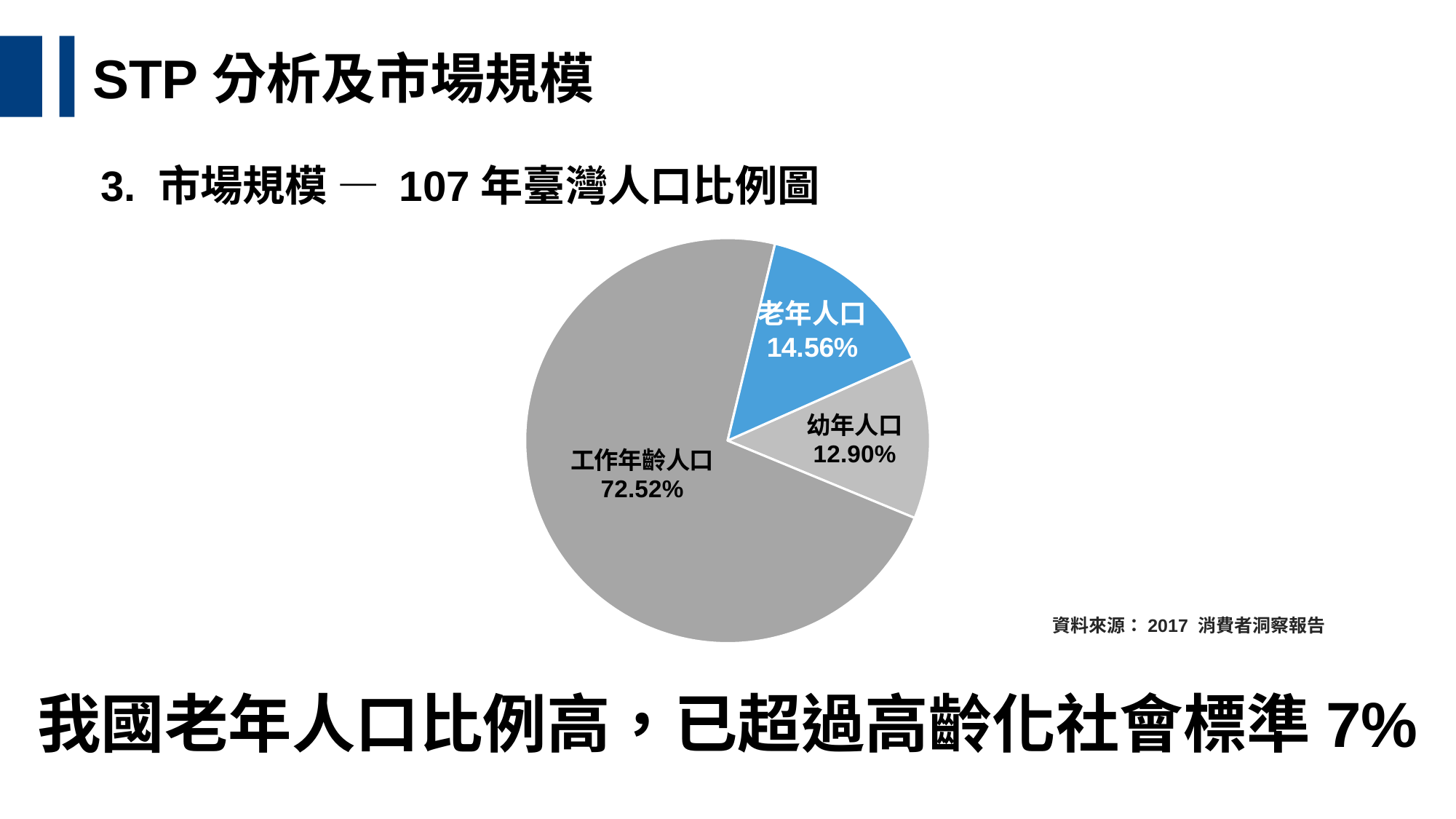
What is the difference between the values for 工作年齡人口 and 老年人口? 57.96% What is the difference between the values for 老年人口 and 幼年人口? 1.66% Which category has the largest slice? 工作年齡人口 Which slice is coloured blue? 老年人口 What is the data source cited below the chart? 2017 消費者洞察報告 Which category has the smallest slice? 幼年人口 What is the value for 工作年齡人口? 72.52% How many slices does the pie chart have? 3 Which is larger, 老年人口 or 幼年人口? 老年人口 What is the value for 老年人口? 14.56% What is the value for 幼年人口? 12.90% What kind of chart is shown on the slide? pie chart